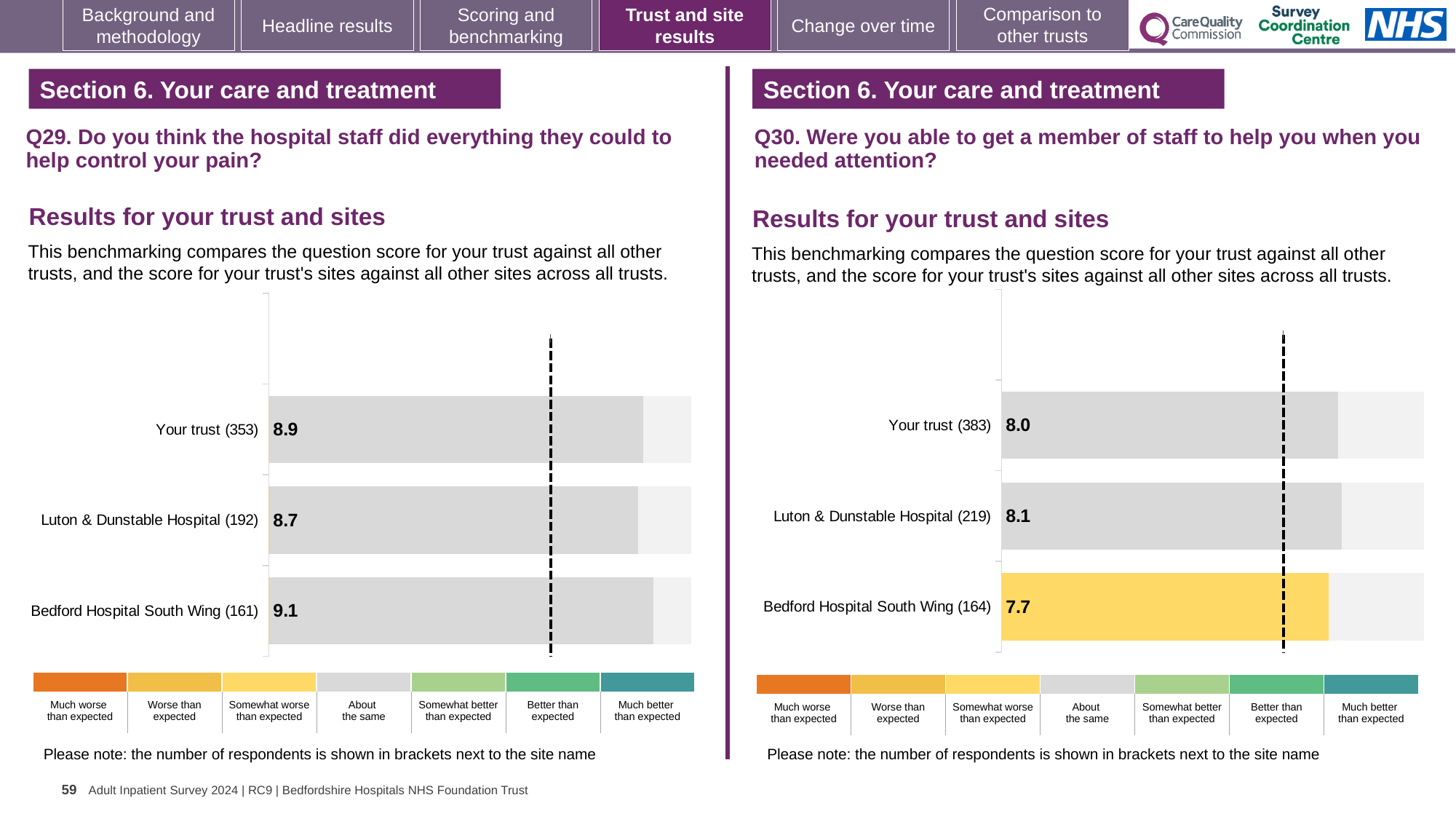
In the Q29 chart on the left, what is the difference between the scores for Bedford Hospital South Wing and Luton & Dunstable Hospital? 0.4 In the Q29 chart on the left, what is the score for Bedford Hospital South Wing? 9.1 How many bars are plotted in the Q29 chart on the left? 3 In the Q30 chart on the right, what is the difference between the scores for Your trust and Bedford Hospital South Wing? 0.3 In the Q30 chart on the right, which bar is coloured yellow rather than grey? Bedford Hospital South Wing In the Q30 chart on the right, what is the score for Bedford Hospital South Wing? 7.7 In the Q29 chart on the left, which site or trust has the lowest score? Luton & Dunstable Hospital In the Q30 chart on the right, which is larger: the score for Your trust or the score for Bedford Hospital South Wing? Your trust In the Q30 chart on the right, which site or trust has the highest score? Luton & Dunstable Hospital In the Q30 chart on the right, what is the score for Luton & Dunstable Hospital? 8.1 In the Q29 chart on the left, what is the score for Your trust? 8.9 In the Q29 chart on the left, how many respondents are shown for Your trust? 353